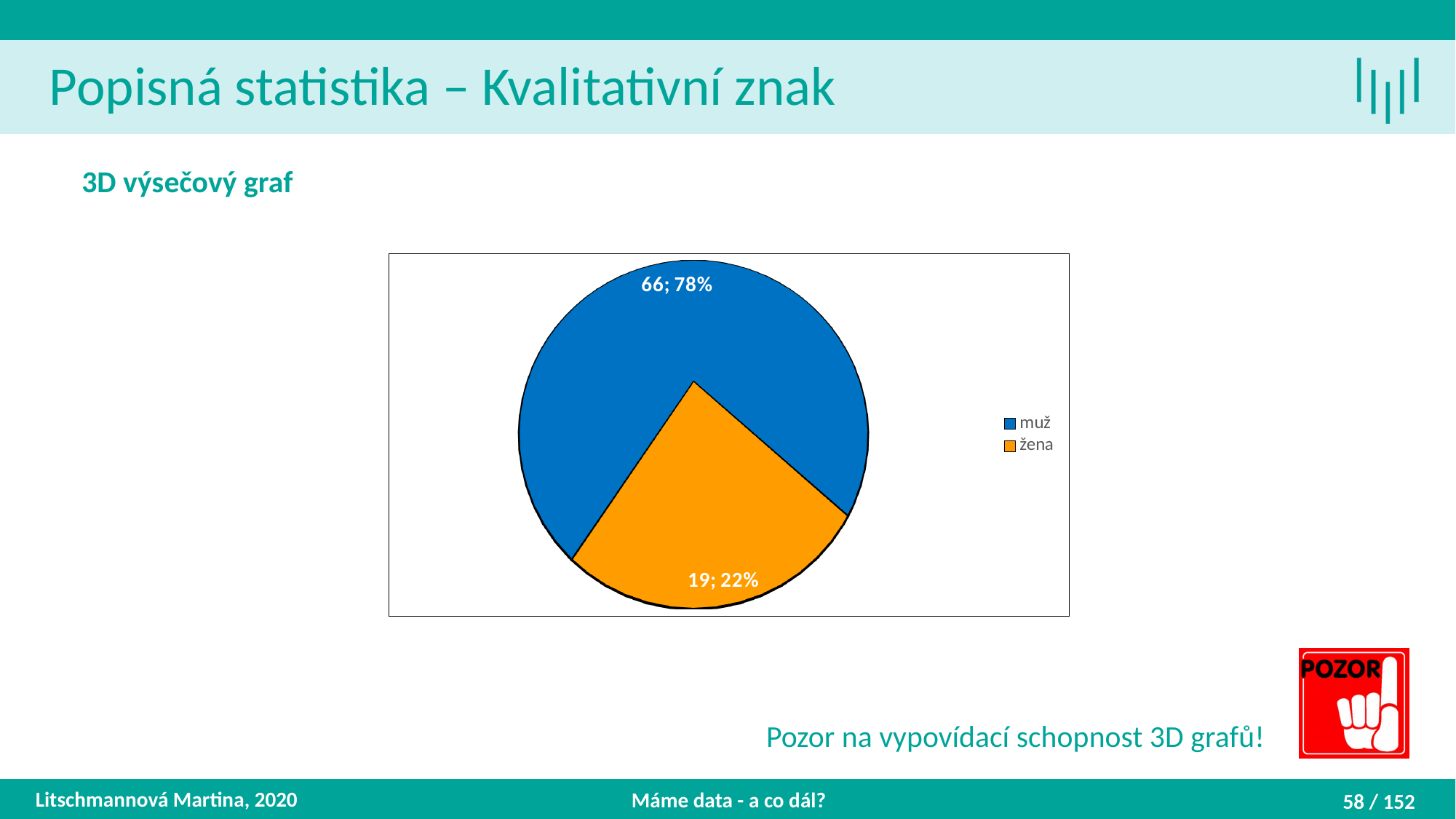
What is the difference between the counts for muž and žena? 47 What colour is the žena slice in the pie chart? orange Which category has the largest slice in the pie chart? muž What is the count for žena in the pie chart? 19 Which is larger, the count for muž or the count for žena? muž Which category has the smallest slice in the pie chart? žena What is the total of the counts shown in the pie chart? 85 What percentage share does the muž slice have? 78% What percentage share does the žena slice have? 22% What kind of chart is shown on the slide? pie chart What is the count for muž in the pie chart? 66 How many categories does the pie chart show? 2